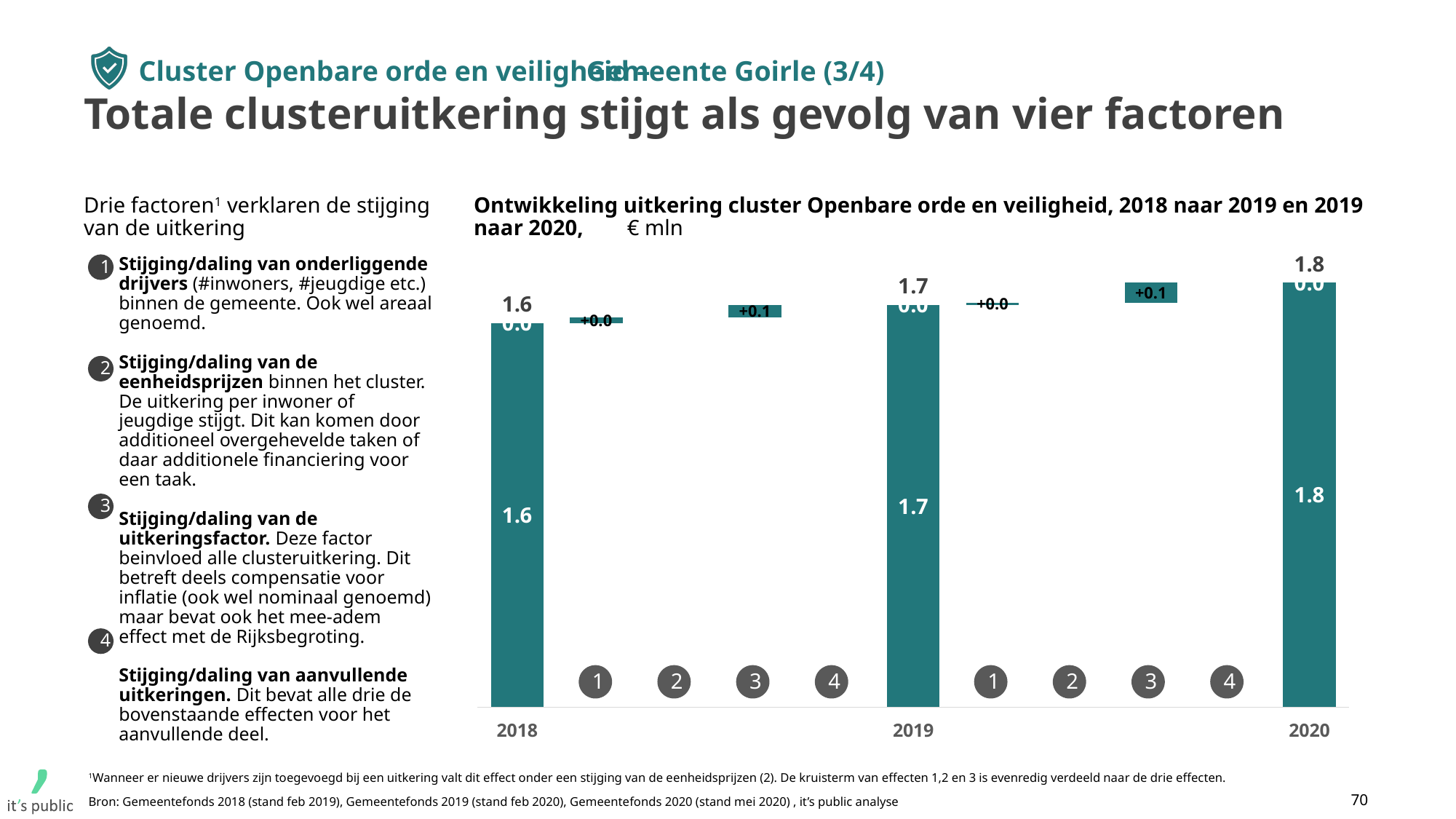
What is the total cluster payment shown for 2018? 1.6 In what unit are the values in the chart expressed? € mln Do the total cluster payments rise or fall from 2018 to 2020? rise Which year has the highest total cluster payment? 2020 What is the effect of factor 1 on the change from 2019 to 2020? +0.0 What is the total cluster payment shown for 2019? 1.7 How many year totals are shown in the chart? 3 Is the total for 2019 larger or smaller than the total for 2018? larger Which year has the lowest total cluster payment? 2018 What is the total cluster payment shown for 2020? 1.8 What is the difference between the 2020 total and the 2018 total? 0.2 What is the effect of factor 3 on the change from 2018 to 2019? +0.1